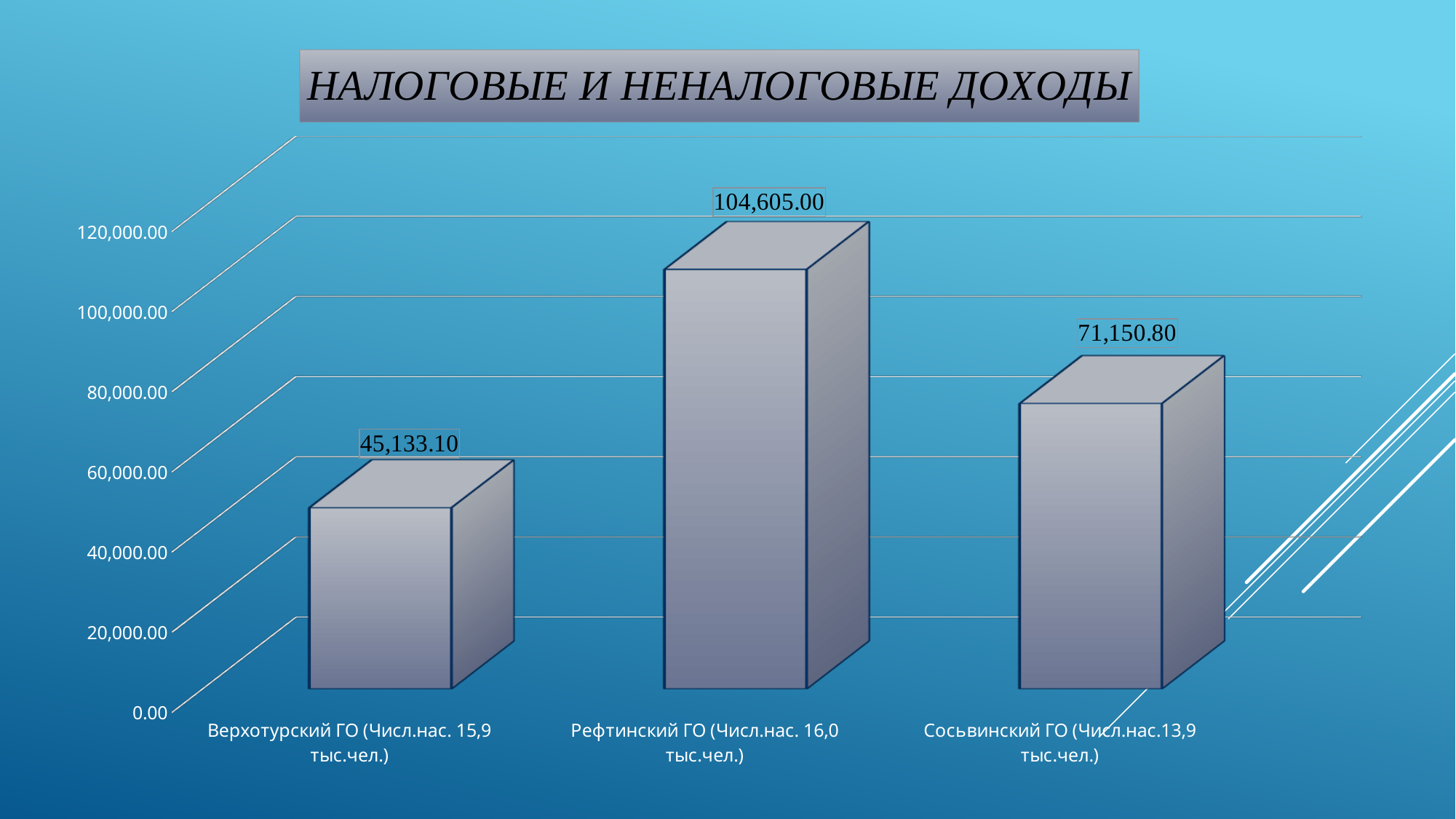
Which category has the lowest value? Верхотурский ГО Is the value for Рефтинский ГО greater or less than 100,000.00? greater What is the difference between the values for Рефтинский ГО and Верхотурский ГО? 59,471.90 What is the value for Верхотурский ГО? 45,133.10 What is the value for Сосьвинский ГО? 71,150.80 Which category has the highest value? Рефтинский ГО What is the difference between the values for Сосьвинский ГО and Верхотурский ГО? 26,017.70 What kind of chart is shown on the slide? bar chart Which is larger, the value for Сосьвинский ГО or the value for Верхотурский ГО? Сосьвинский ГО How many categories are shown in the chart? 3 What is the value for Рефтинский ГО? 104,605.00 What is the title of the chart? НАЛОГОВЫЕ И НЕНАЛОГОВЫЕ ДОХОДЫ